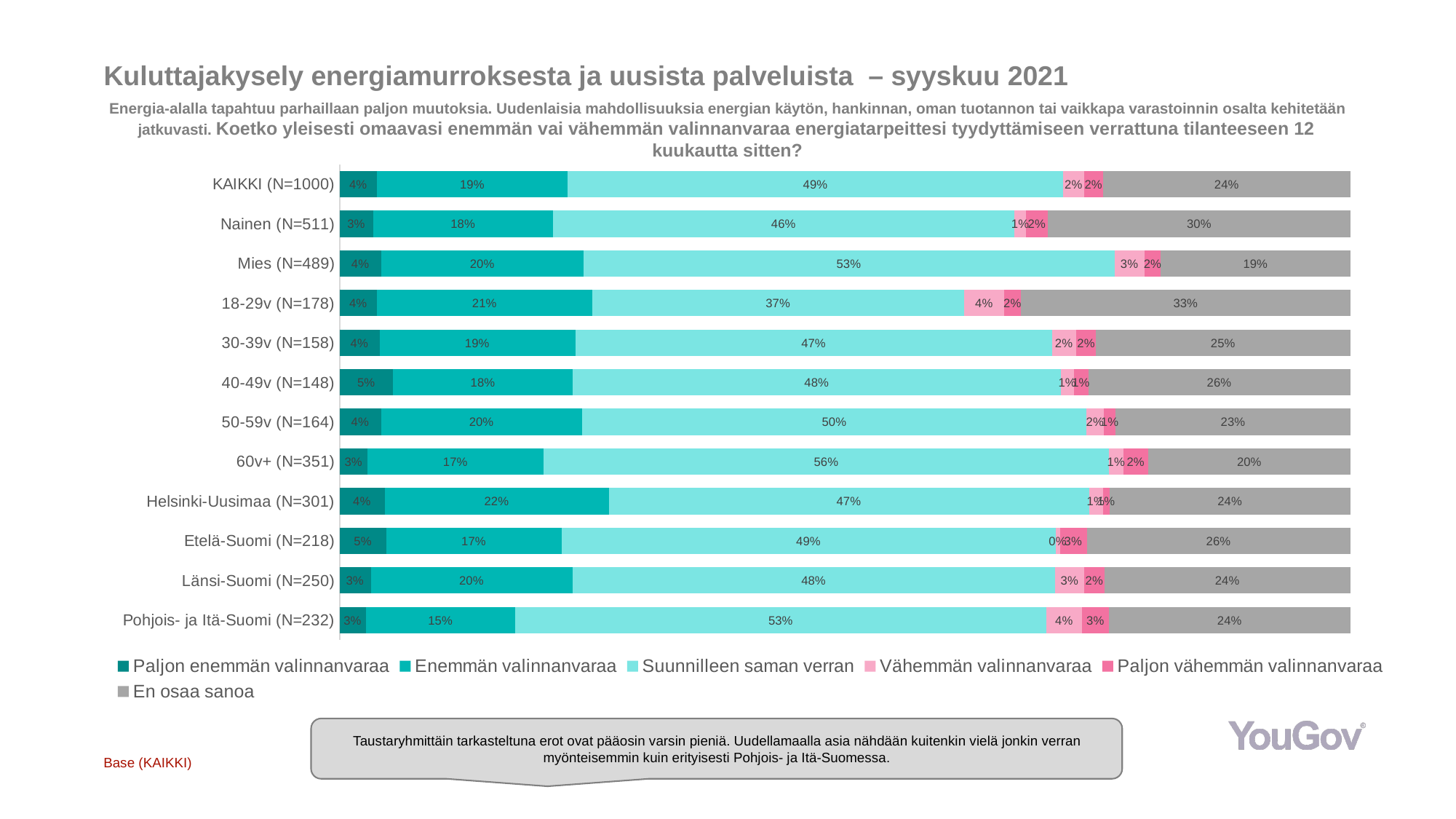
What is the value of "En osaa sanoa" for Nainen (N=511)? 30% Which group has the highest value for "En osaa sanoa"? 18-29v (N=178) What is the value of "Suunnilleen saman verran" for KAIKKI (N=1000)? 49% Which group has the lowest value for "Suunnilleen saman verran"? 18-29v (N=178) Which group has the highest value for "Suunnilleen saman verran"? 60v+ (N=351) Which is larger: "Suunnilleen saman verran" for Mies (N=489) or for Nainen (N=511)? Mies (N=489) What is the value of "Enemmän valinnanvaraa" for Helsinki-Uusimaa (N=301)? 22% What is the difference in "En osaa sanoa" between Nainen (N=511) and Mies (N=489)? 11 percentage points How many series does the legend list? 6 Which group has the lowest value for "Enemmän valinnanvaraa"? Pohjois- ja Itä-Suomi (N=232) What kind of chart is shown on the slide? Stacked bar chart How many respondent groups (bars) are shown in the chart? 12